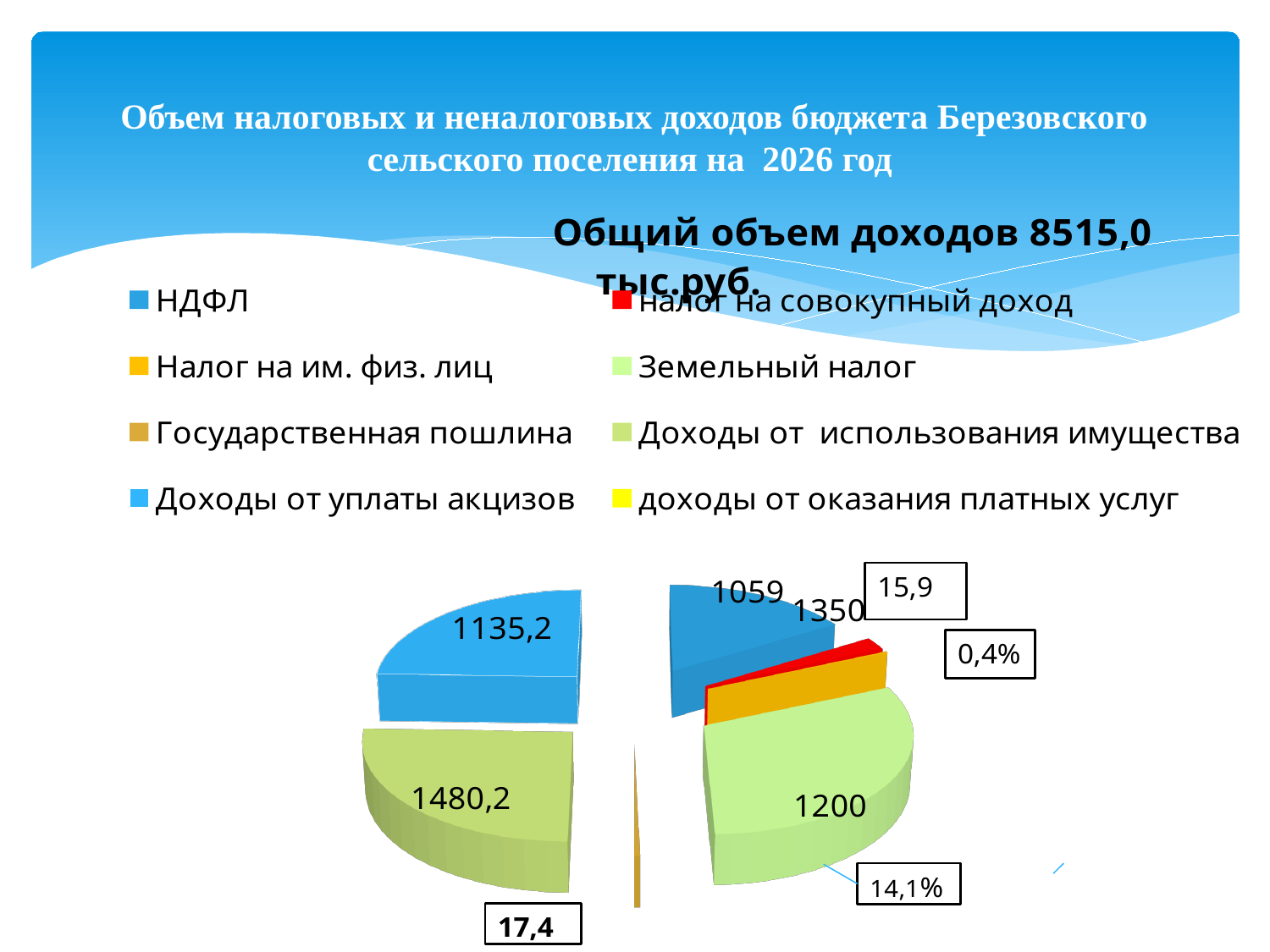
What value is labelled on the slice for Доходы от уплаты акцизов (light blue)? 1135,2 Which is larger, the value for Доходы от использования имущества or the value for Земельный налог? Доходы от использования имущества How many entries does the chart legend list? 8 What percentage is shown in the box pointing to the Земельный налог slice? 14,1% What is the difference between the Доходы от использования имущества slice (1480,2) and the Земельный налог slice (1200)? 280,2 What total revenue figure is stated above the chart? 8515,0 тыс.руб. What year does the chart title refer to? 2026 Which of the labelled slices has the highest value? Доходы от использования имущества (1480,2) What kind of chart is shown on the slide? pie chart What is the difference between the Доходы от использования имущества slice (1480,2) and the Доходы от уплаты акцизов slice (1135,2)? 345 What value is labelled on the slice for Доходы от использования имущества (olive green)? 1480,2 What value is labelled on the slice for Земельный налог (light green)? 1200